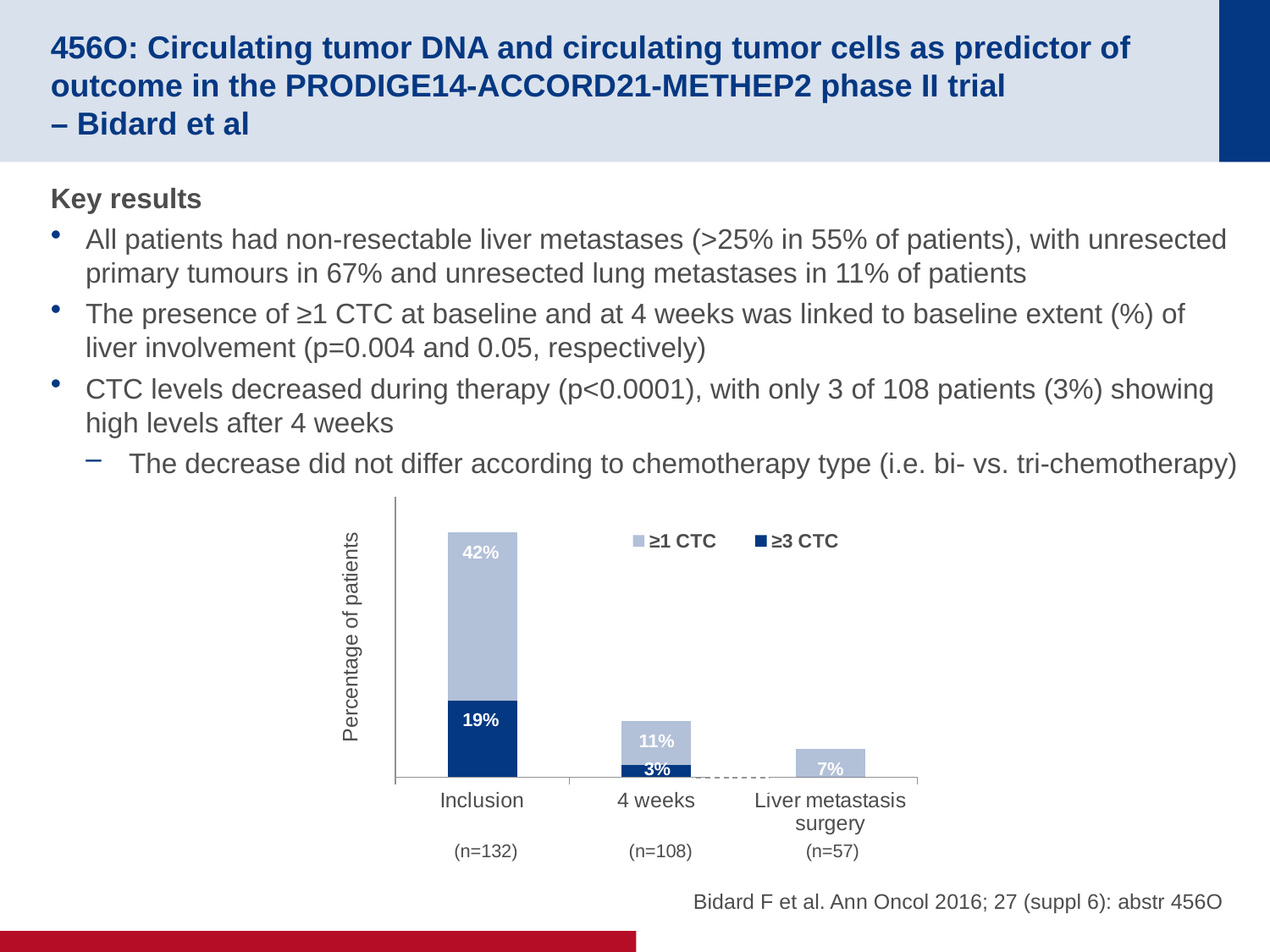
How many series does the chart legend list? 2 What percentage of patients had ≥1 CTC at Liver metastasis surgery? 7% Which is larger: the ≥1 CTC percentage at 4 weeks or at Liver metastasis surgery? 4 weeks At which time point is the percentage of patients with ≥1 CTC highest? Inclusion What is the difference between the ≥3 CTC percentage at Inclusion and at 4 weeks? 16% What percentage of patients had ≥1 CTC at Inclusion? 42% At which time point is the percentage of patients with ≥1 CTC lowest? Liver metastasis surgery What percentage of patients had ≥3 CTC at Inclusion? 19% How many time points are shown on the x axis of the chart? 3 What percentage of patients had ≥3 CTC at 4 weeks? 3% What percentage of patients had ≥1 CTC at 4 weeks? 11% What is the difference between the ≥1 CTC percentage at Inclusion and at 4 weeks? 31%